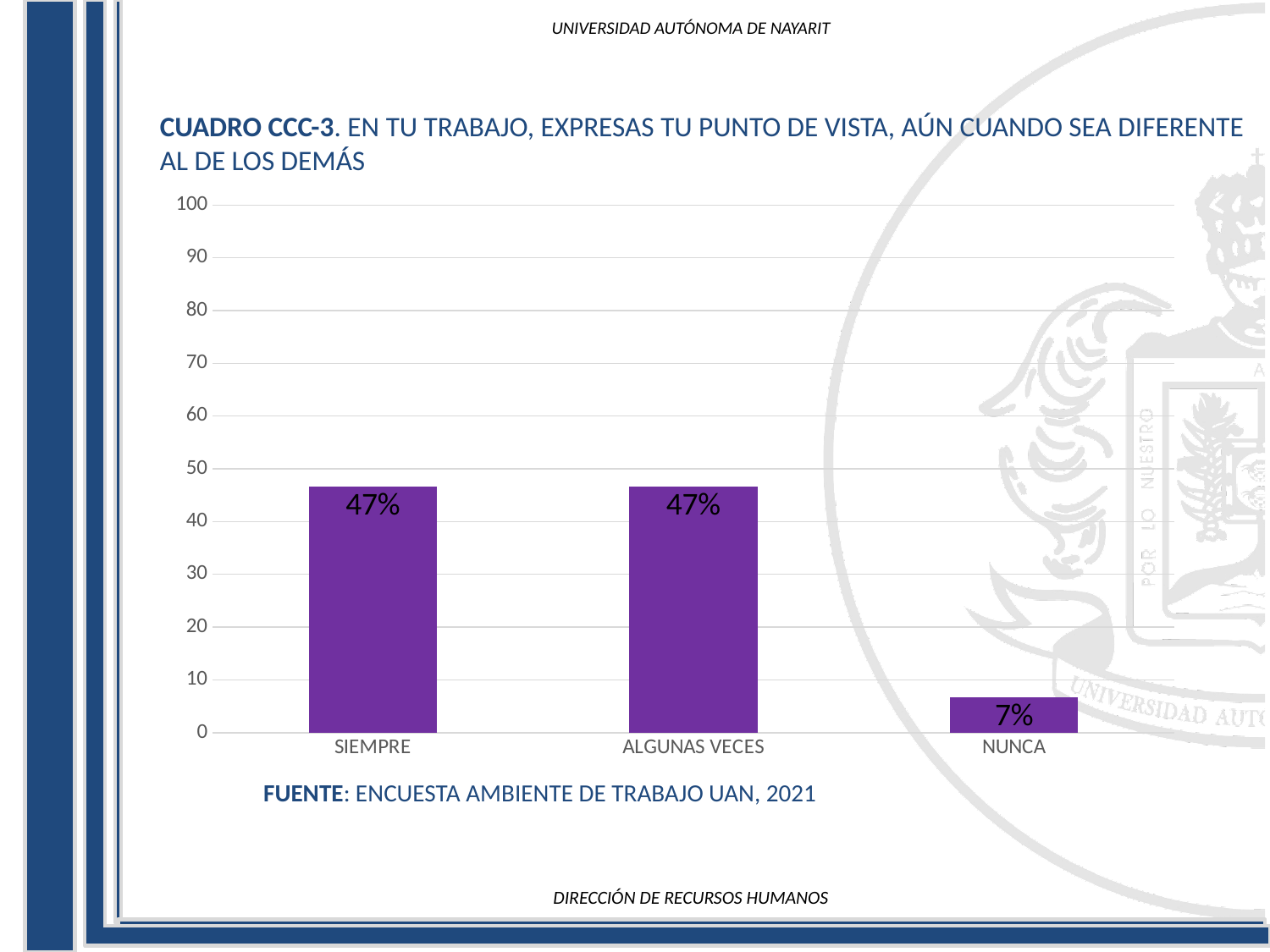
What is the difference between the values for SIEMPRE and NUNCA? 40% What is the highest value shown on the vertical axis? 100 Which category has the lowest value? NUNCA What kind of chart is shown on the slide? bar chart What is the value for SIEMPRE? 47% What is the value for ALGUNAS VECES? 47% What is the source cited below the chart? ENCUESTA AMBIENTE DE TRABAJO UAN, 2021 Is the value for SIEMPRE greater or less than 40? greater What is the value for NUNCA? 7% Is the value for NUNCA greater or less than 10? less How many categories are shown on the x axis? 3 Which is larger, the value for ALGUNAS VECES or the value for NUNCA? ALGUNAS VECES